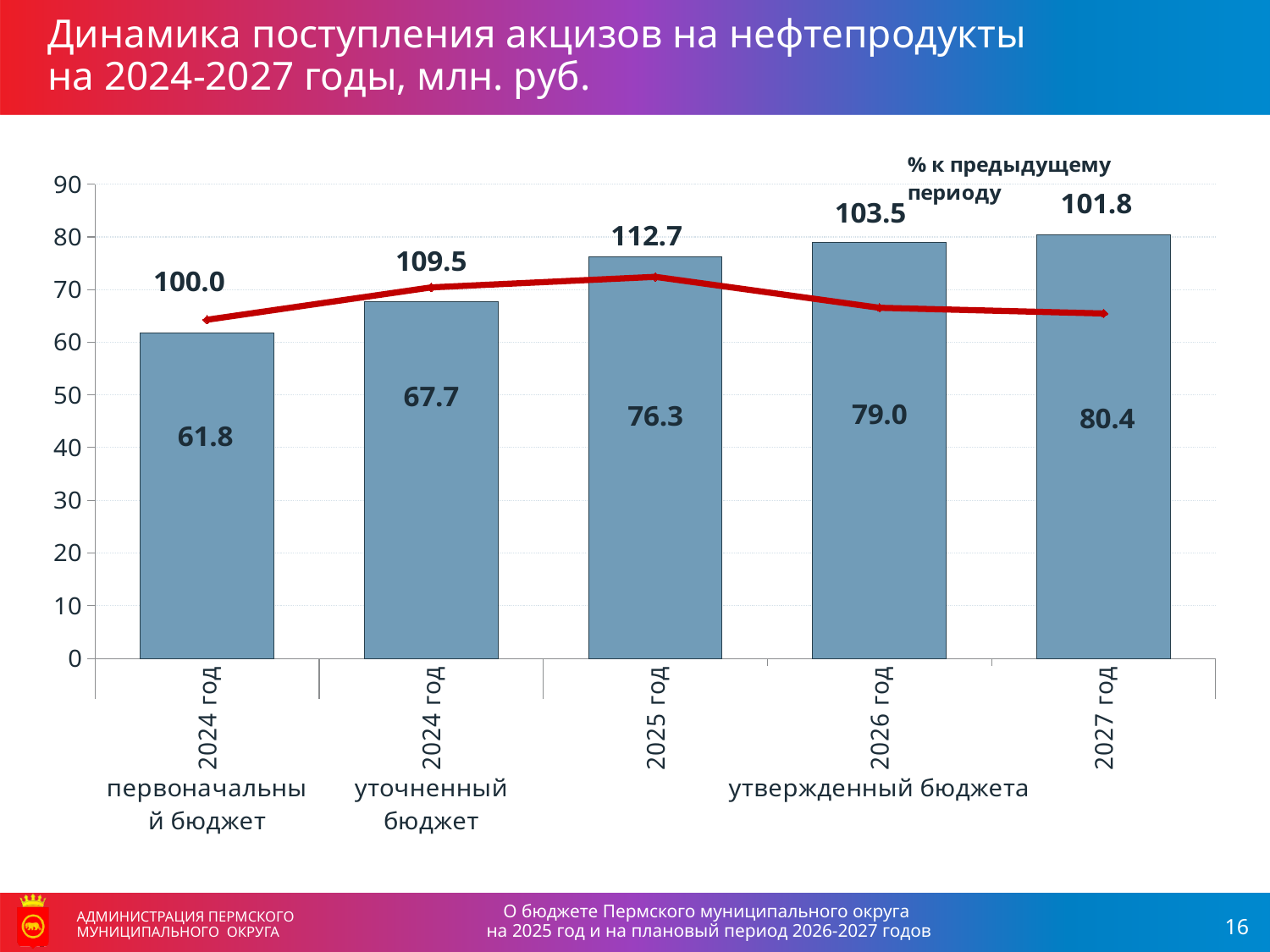
What is the value of the bar for 2024 год (первоначальный бюджет)? 61.8 Which is larger: the '% к предыдущему периоду' value for 2025 год or for 2027 год? 2025 год Do the bar values rise or fall from 2024 год (первоначальный бюджет) to 2027 год? rise What is the '% к предыдущему периоду' value shown for 2024 год (уточненный бюджет)? 109.5 What is the unit of measurement stated in the chart title? млн. руб. What is the '% к предыдущему периоду' value shown for 2026 год? 103.5 Which year has the highest bar value? 2027 год What is the difference between the bar values for 2024 год (уточненный бюджет) and 2024 год (первоначальный бюджет)? 5.9 Which category has the lowest bar value? 2024 год (первоначальный бюджет) What is the difference between the bar values for 2027 год and 2026 год? 1.4 How many bars are plotted on the chart? 5 What is the excise revenue value shown for 2025 год? 76.3